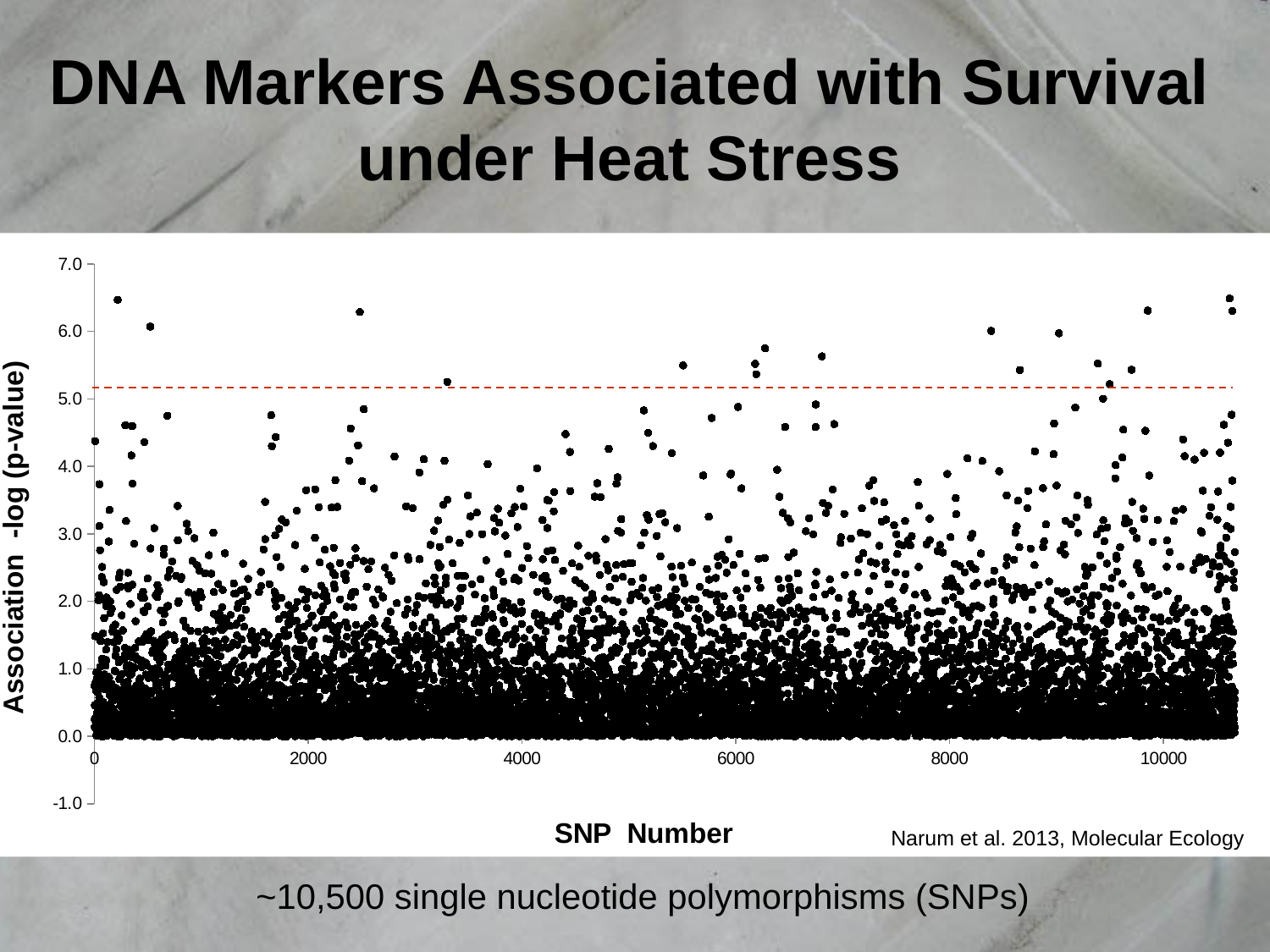
What kind of chart is shown on the slide? scatter chart Are most of the plotted points on the chart above or below 2.0 on the y axis? below What is the largest value labelled on the x axis of the chart? 10000 Is the highest plotted point on the chart greater or less than 7.0 on the y axis? less Is the dashed horizontal line on the chart greater or less than 5.0 on the y axis? greater What is the lowest value labelled on the y axis of the chart? -1.0 What is the title of the slide containing the chart? DNA Markers Associated with Survival under Heat Stress What is the label on the y axis of the chart? Association -log (p-value) What is the highest value labelled on the y axis of the chart? 7.0